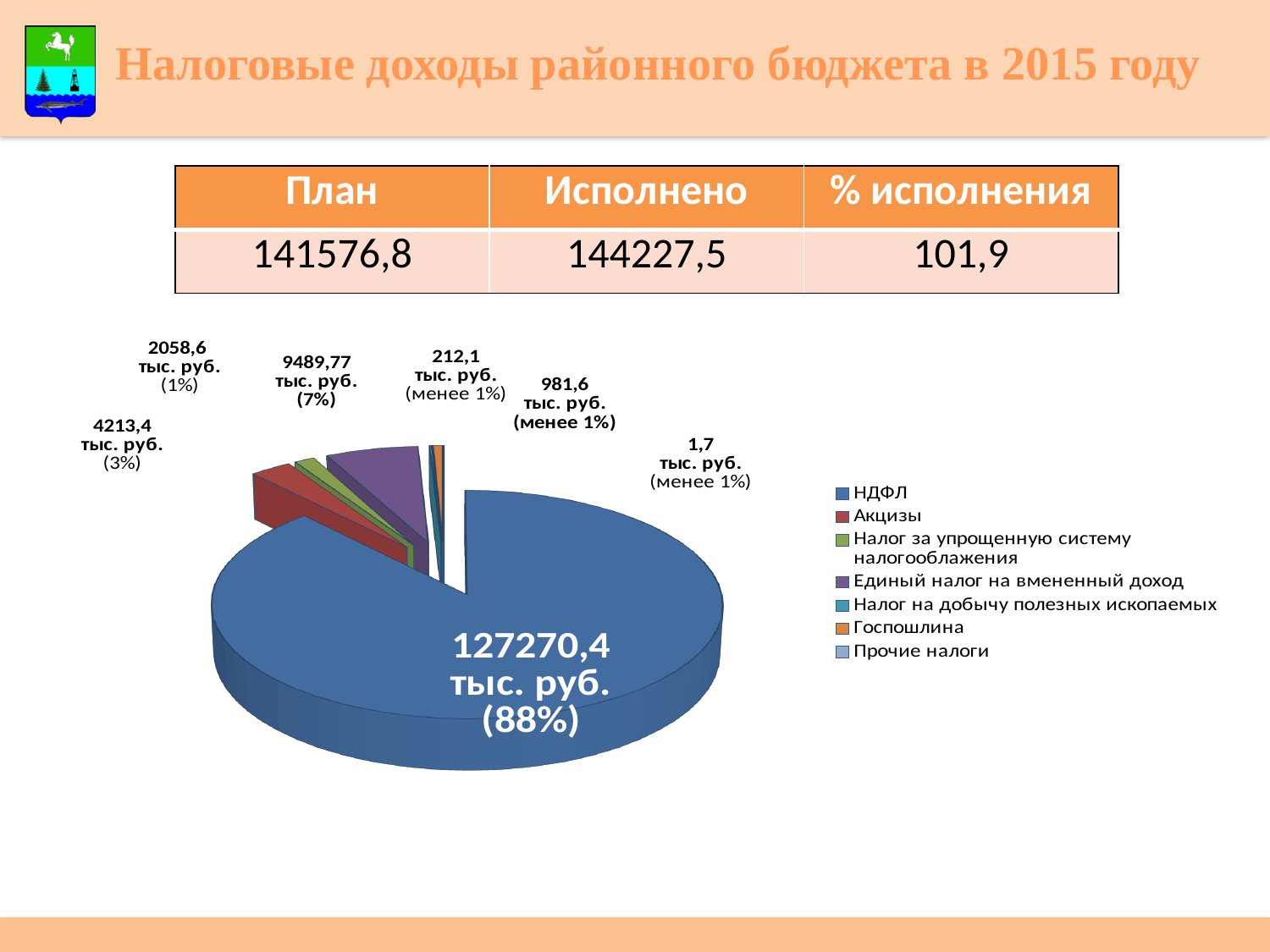
What is the value shown for Акцизы in the pie chart? 4213,4 тыс. руб. What share of the pie does Единый налог на вмененный доход account for? 7% What share of the pie does НДФЛ account for? 88% What is the value shown for Единый налог на вмененный доход in the pie chart? 9489,77 тыс. руб. Which category has the largest slice in the pie chart? НДФЛ What is the title of the slide containing the pie chart? Налоговые доходы районного бюджета в 2015 году What is the value shown for НДФЛ in the pie chart? 127270,4 тыс. руб. Which is larger in the pie chart: Акцизы or Единый налог на вмененный доход? Единый налог на вмененный доход How many slices does the pie chart have? 7 How many entries does the legend of the pie chart list? 7 What kind of chart is shown on the slide? pie chart What is the difference between the values for НДФЛ and Единый налог на вмененный доход? 117780,63 тыс. руб.